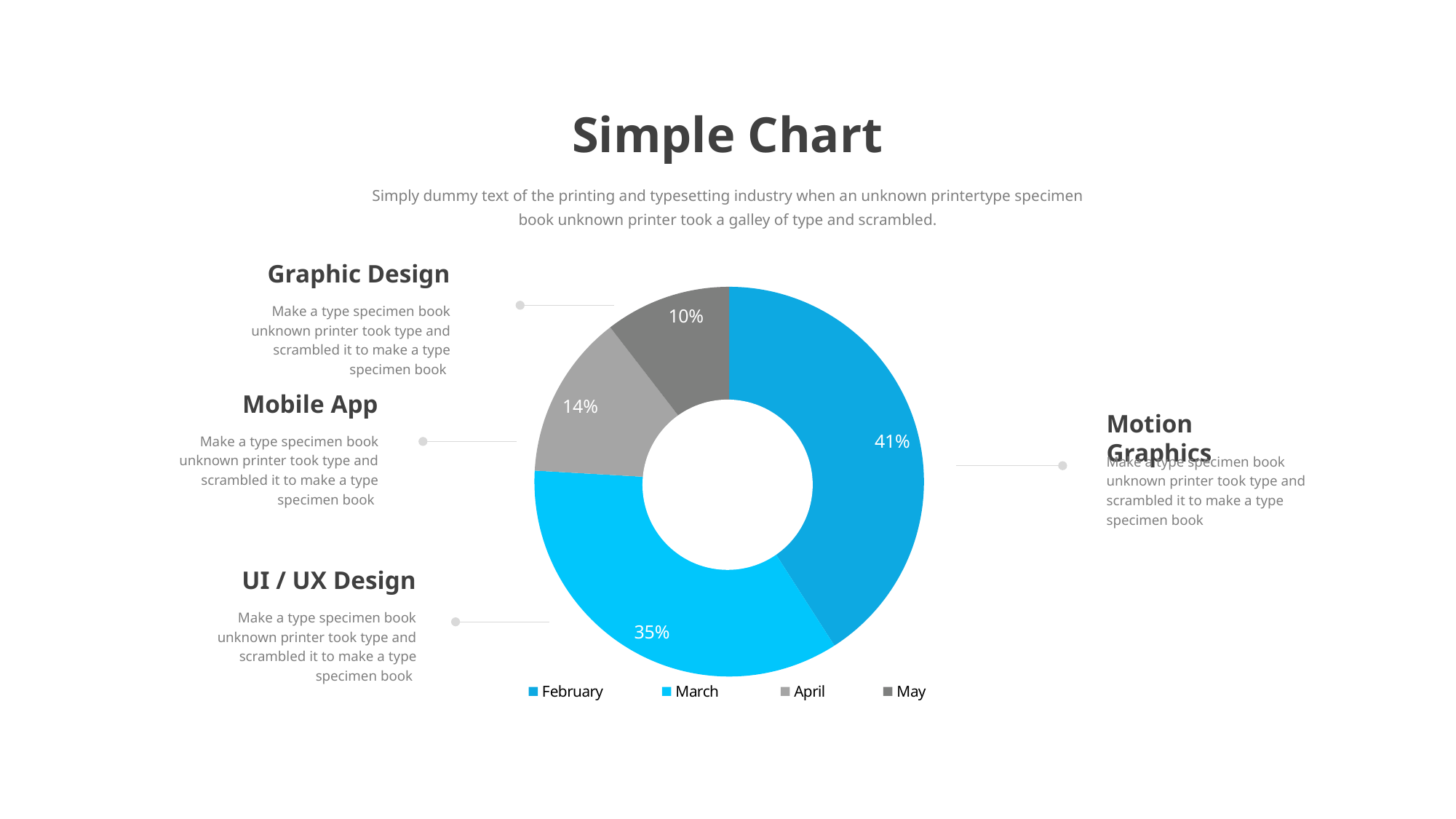
What kind of chart is shown on the slide? Doughnut (pie) chart What percentage is shown for April? 14% How many categories does the legend list? 4 Which category has the largest share of the chart? February What percentage is shown for May? 10% What colour is the May slice in the chart? Dark grey What percentage is shown for March? 35% Which category has the smallest share of the chart? May What is the title of the slide containing the chart? Simple Chart What percentage is shown for February? 41% Which is larger, the share for April or the share for May? April What is the difference in percentage points between February and March? 6